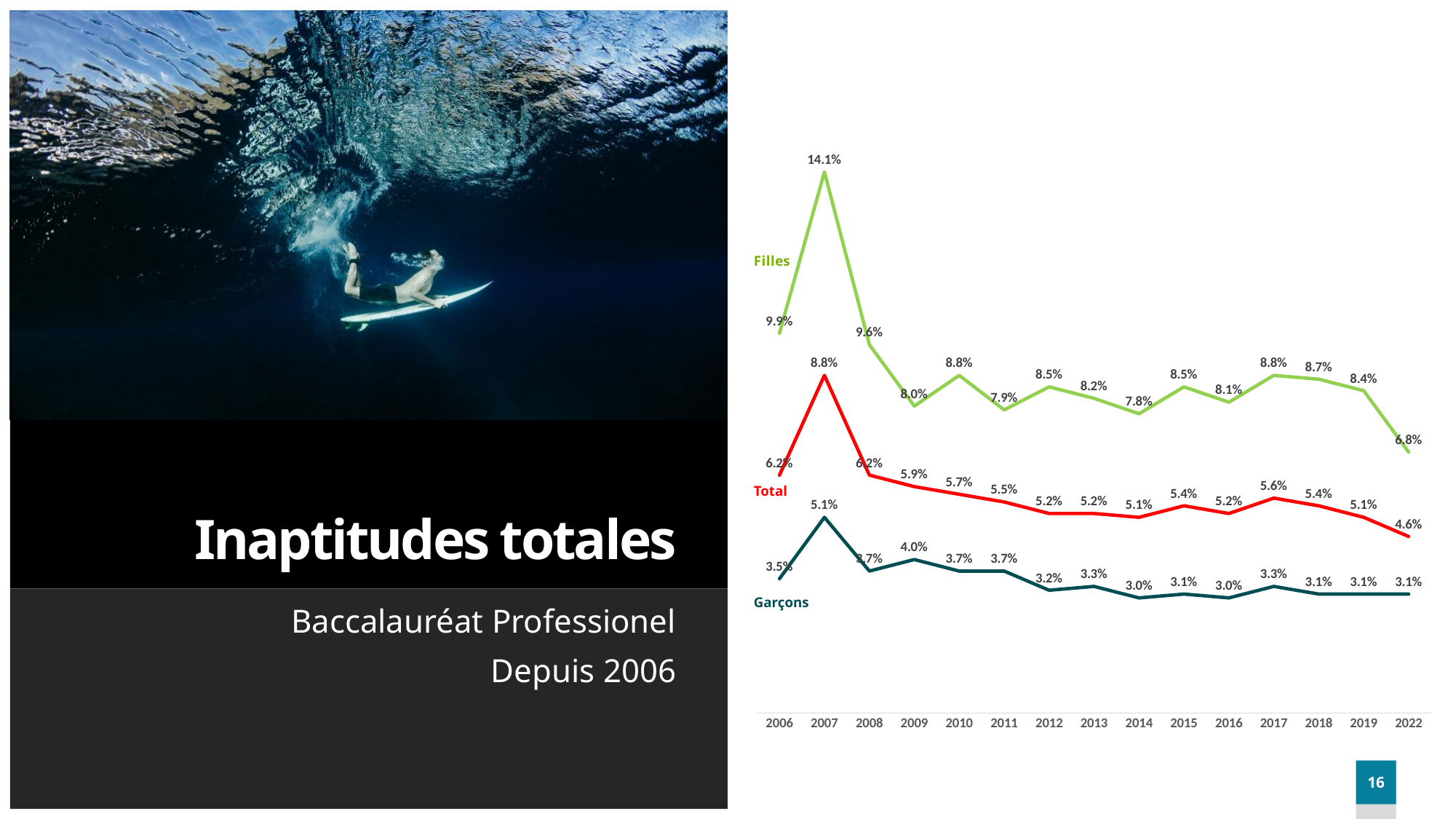
In which year does the Total series reach its lowest value? 2022 How many years are shown on the x axis? 15 In which year does the Filles series reach its highest value? 2007 Which is larger, the Filles value in 2010 or the Filles value in 2011? 2010 What is the difference between the Total value in 2006 and in 2022? 1.6% What is the value for Total in 2022? 4.6% Does the Total series rise or fall from 2007 to 2022? fall How many series does the chart show? 3 What is the value for Garçons in 2009? 4.0% What type of chart is shown on the slide? line chart What is the difference between the Filles value and the Garçons value in 2007? 9.0% What is the value for Filles in 2007? 14.1%